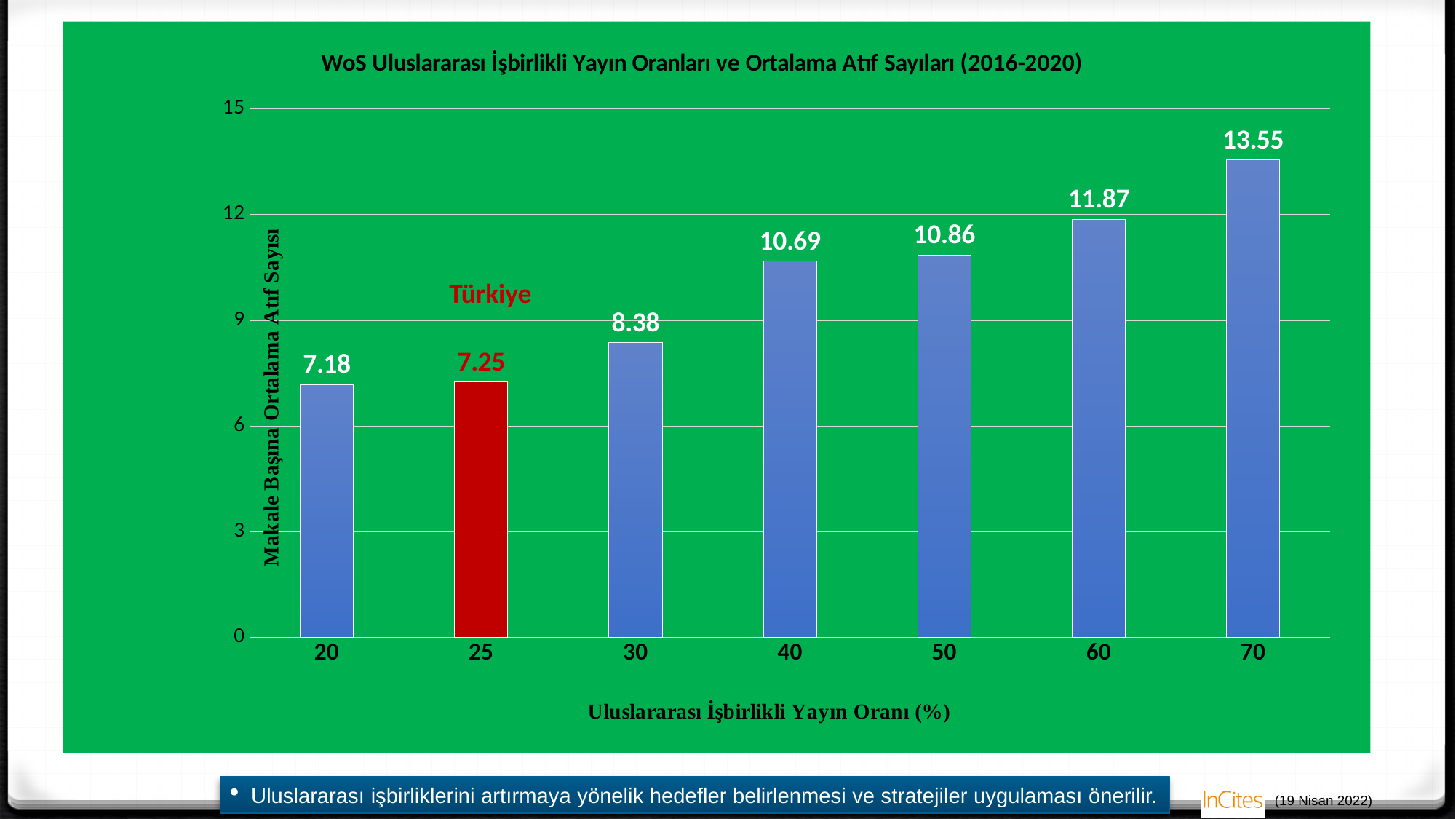
Which is larger, the value for the 50% category or the value for the 40% category? 50 Is the value for the 60% category greater or less than 12? less What is the value shown for the 40% international collaboration rate category? 10.69 What is the value shown for the 60% international collaboration rate category? 11.87 What is the difference between the values for the 70% and 20% categories? 6.37 Do the values rise or fall as the international collaboration rate increases along the x axis? rise What is the difference between the values for the 30% and 25% categories? 1.13 Which international collaboration rate category has the highest average citation count? 70 What is the average citation count per article for the 25% international collaboration rate category (Türkiye)? 7.25 Which international collaboration rate category has the lowest average citation count? 20 How many categories are shown on the x axis? 7 What kind of chart is shown on the slide? bar chart